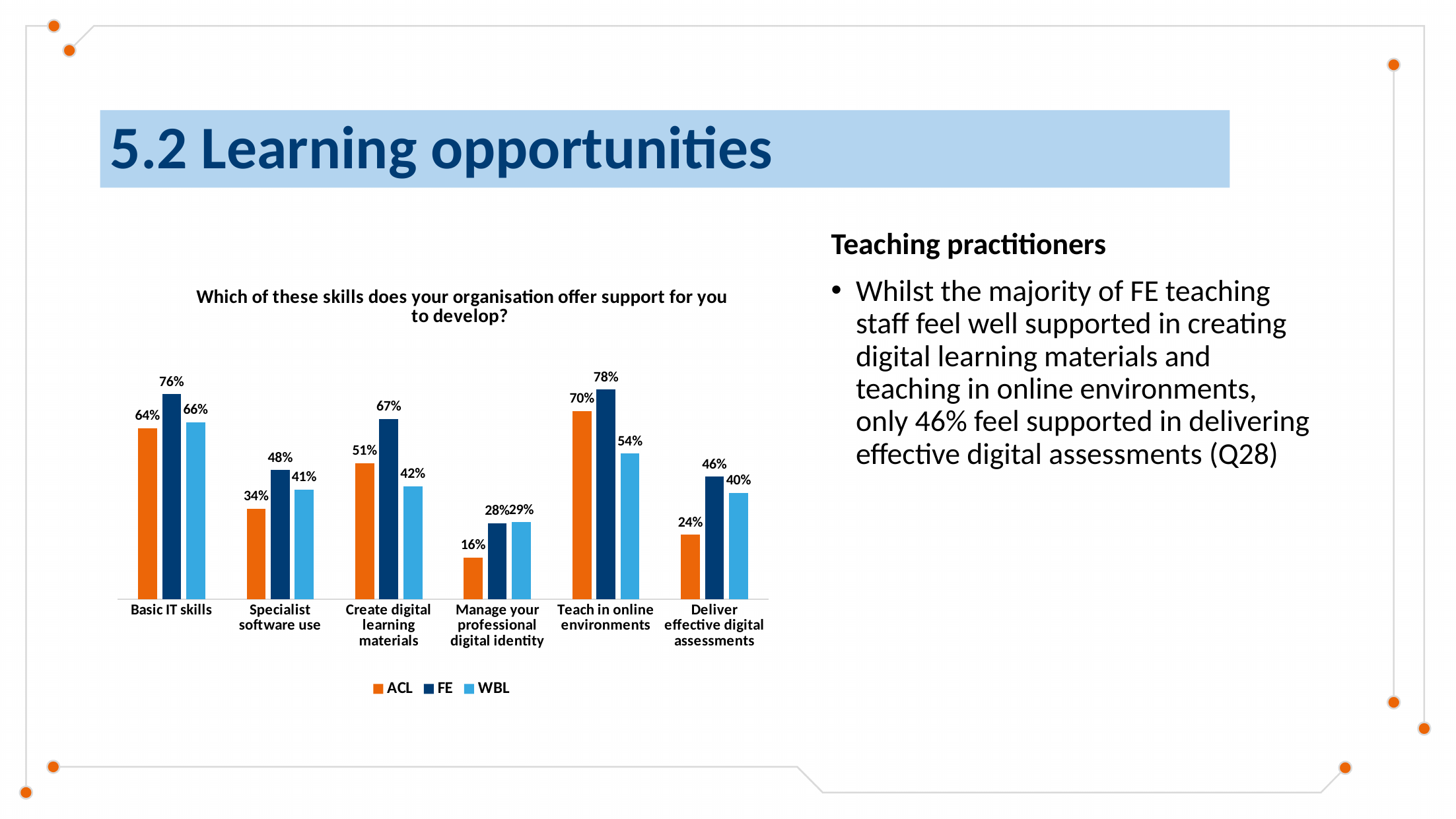
Which category has the highest FE value? Teach in online environments Which category has the lowest ACL value? Manage your professional digital identity For Create digital learning materials, which is larger: the ACL value or the WBL value? ACL What is the title of the chart? Which of these skills does your organisation offer support for you to develop? What is the FE value for Basic IT skills? 76% Which series is shown in orange in the legend? ACL How many skill categories are shown on the x axis? 6 What is the WBL value for Teach in online environments? 54% What is the ACL value for Manage your professional digital identity? 16% How many series does the legend list? 3 What is the difference between the FE and ACL values for Deliver effective digital assessments? 22% What kind of chart is shown on the slide? Bar chart